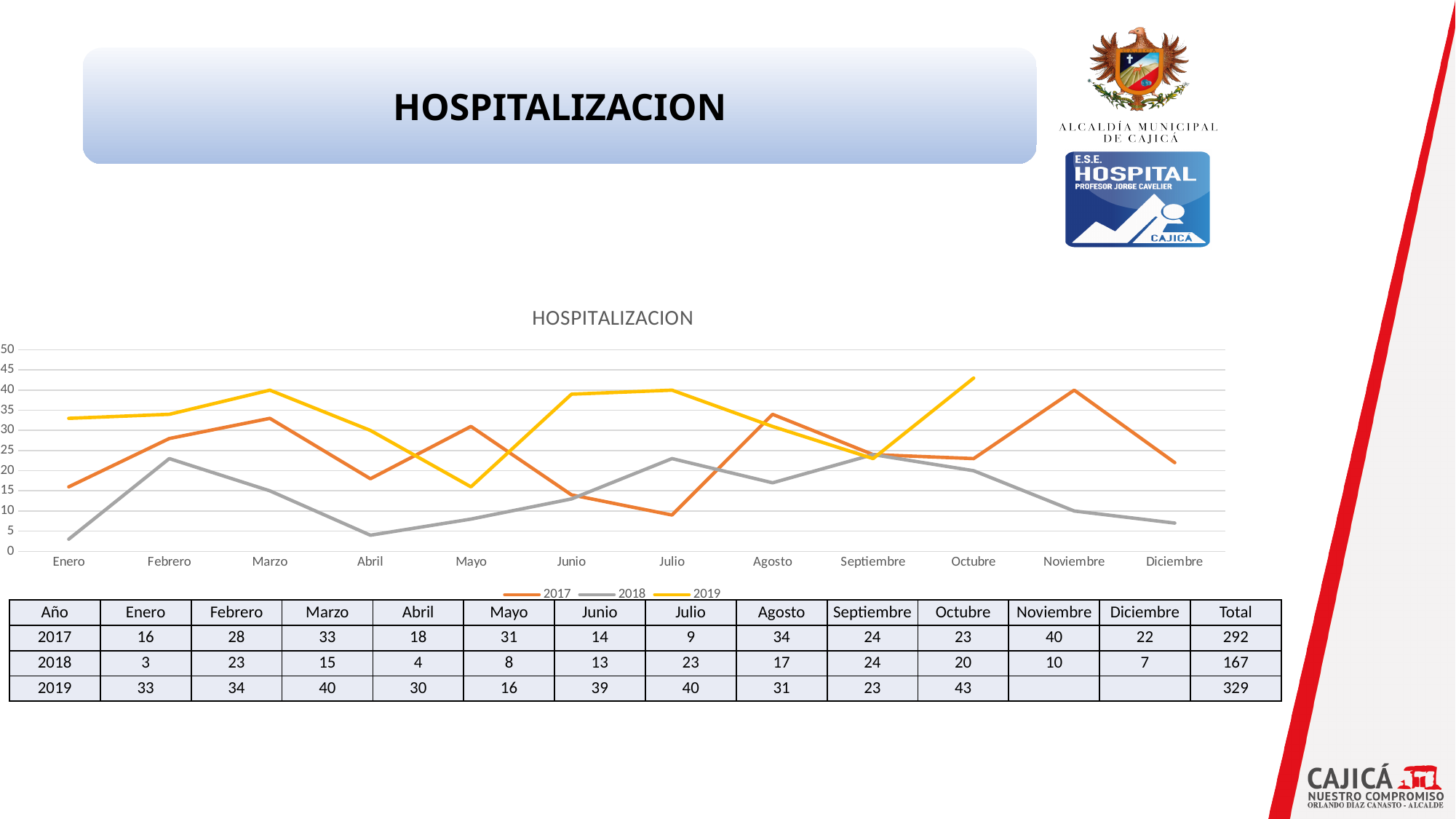
Is the value for 2019 in Octubre greater or less than 40? greater How many months are shown on the x axis of the chart? 12 In which month does the 2017 series reach its highest value? Noviembre Which series is drawn in yellow on the chart? 2019 How many series does the chart legend list? 3 What kind of chart is shown on the slide? line chart What is the difference between the 2019 and 2018 values in Marzo? 25 What is the value for 2017 in Noviembre? 40 Which series has the higher value in Julio, 2017 or 2019? 2019 In which month does the 2018 series have its lowest value? Enero What is the value for 2018 in Enero? 3 What is the value for 2019 in Octubre? 43